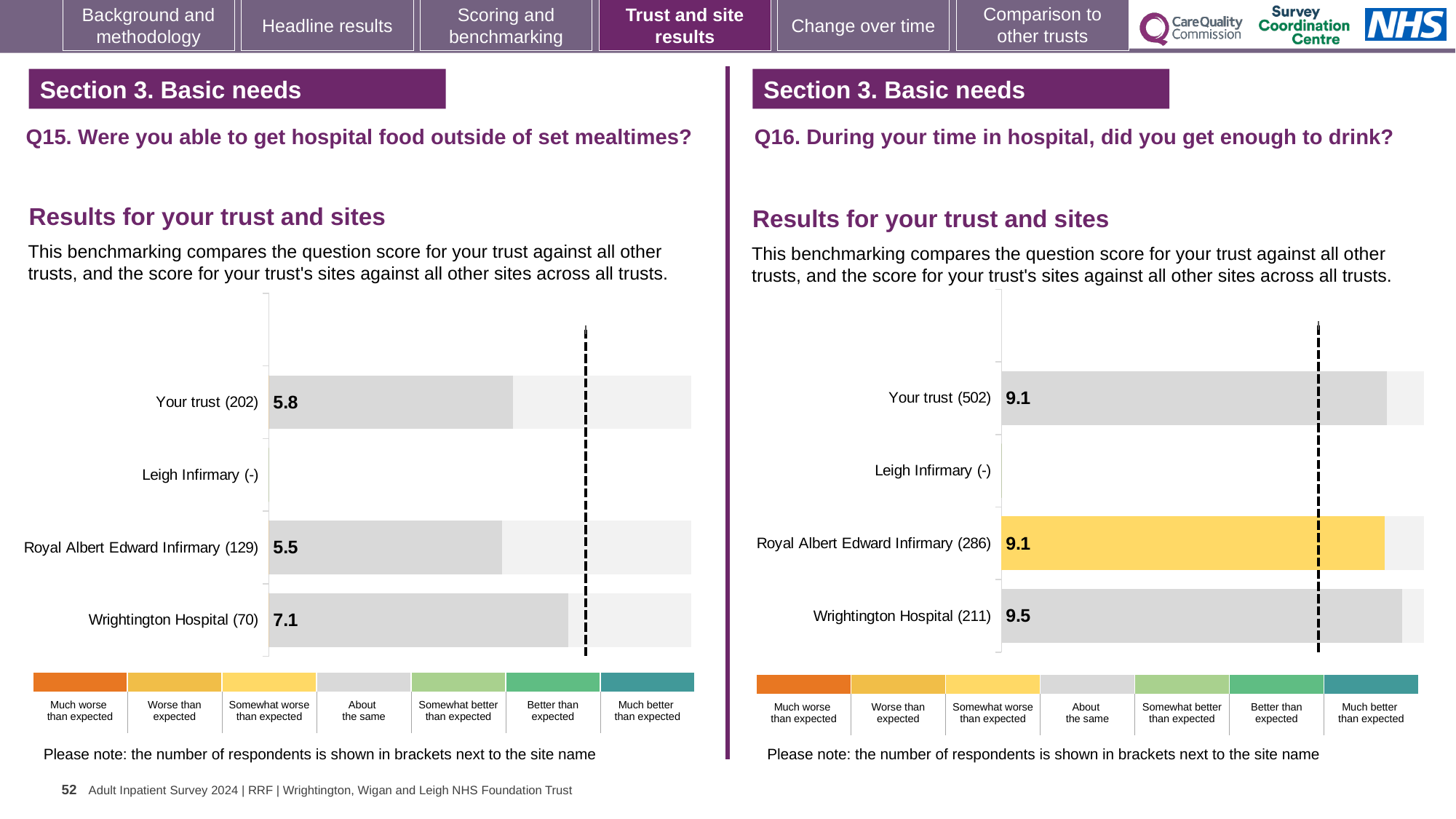
On the Q15 chart (left), which is larger: the score for Your trust (202) or Royal Albert Edward Infirmary (129)? Your trust (202) How many rows (trust and sites) are listed on the Q15 chart (left)? 4 On the Q15 chart (left), which site has the highest score? Wrightington Hospital (70) On the Q16 chart (right), what is the score for Wrightington Hospital (211)? 9.5 On the Q16 chart (right), which site has the highest score? Wrightington Hospital (211) On the Q16 chart (right), what is the score for Royal Albert Edward Infirmary (286)? 9.1 On the Q16 chart (right), what is the difference between the scores for Wrightington Hospital (211) and Your trust (502)? 0.4 On the Q15 chart (left), what is the score for Wrightington Hospital (70)? 7.1 What kind of chart is used on the Q16 chart (right)? Bar chart On the Q15 chart (left), what is the score for Your trust (202)? 5.8 On the Q16 chart (right), which benchmark category does the colour of the Royal Albert Edward Infirmary (286) bar indicate? Somewhat worse than expected On the Q15 chart (left), what is the difference between the scores for Wrightington Hospital (70) and Royal Albert Edward Infirmary (129)? 1.6